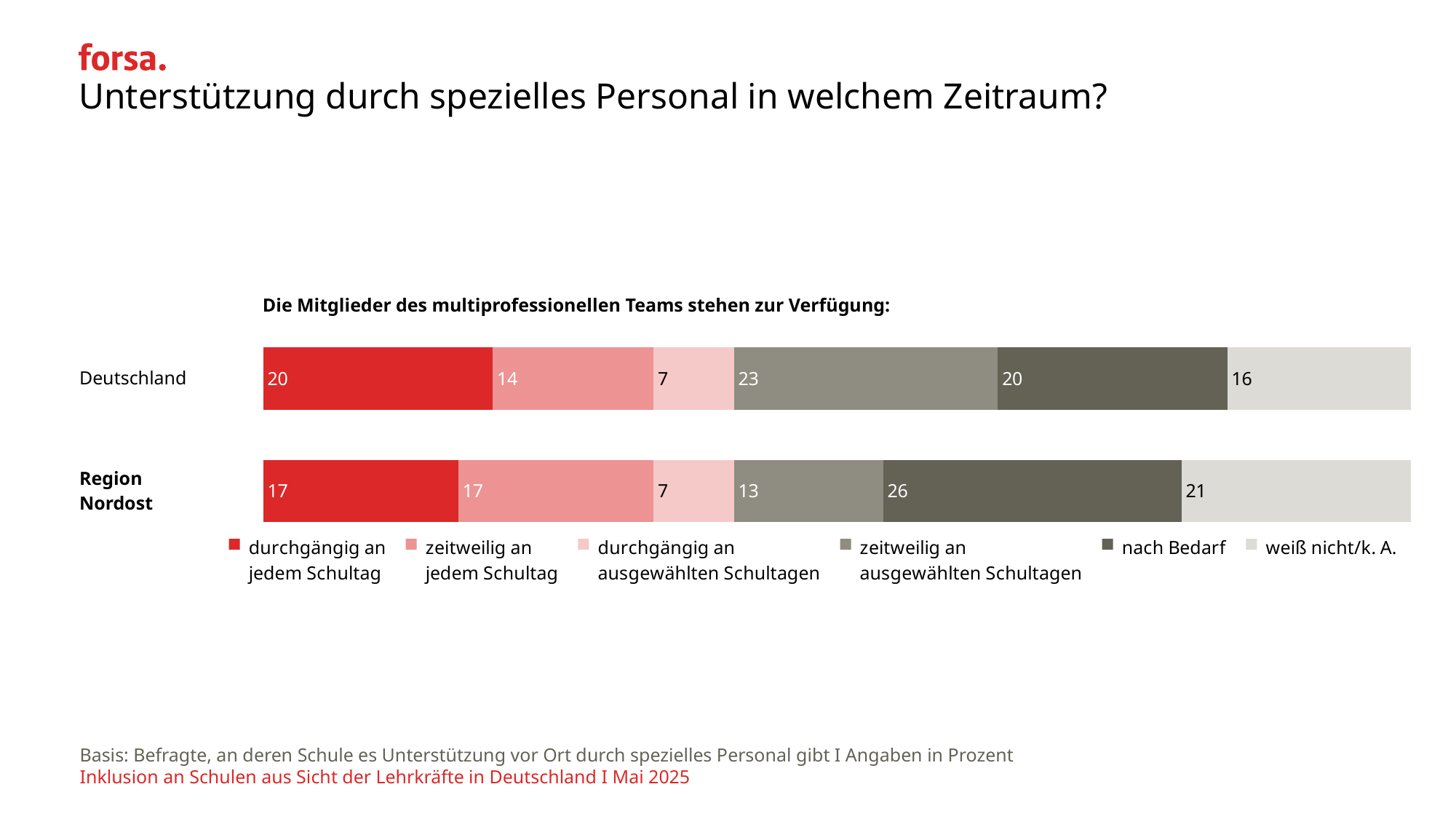
What kind of chart is shown on the slide? stacked bar chart How many categories (bars) are shown in the chart? 2 What is the difference between the "zeitweilig an ausgewählten Schultagen" values for Deutschland and Region Nordost? 10 Which is larger: the "nach Bedarf" value for Deutschland or for Region Nordost? Region Nordost What is the value for "weiß nicht/k. A." for Region Nordost? 21 What is the total of the Deutschland stacked bar? 100 Which series has the lowest value in the Deutschland bar? durchgängig an ausgewählten Schultagen What is the value for "zeitweilig an ausgewählten Schultagen" for Deutschland? 23 What is the value for "nach Bedarf" for Region Nordost? 26 Which series has the highest value in the Region Nordost bar? nach Bedarf What is the value for "durchgängig an jedem Schultag" for Deutschland? 20 How many series does the legend list? 6